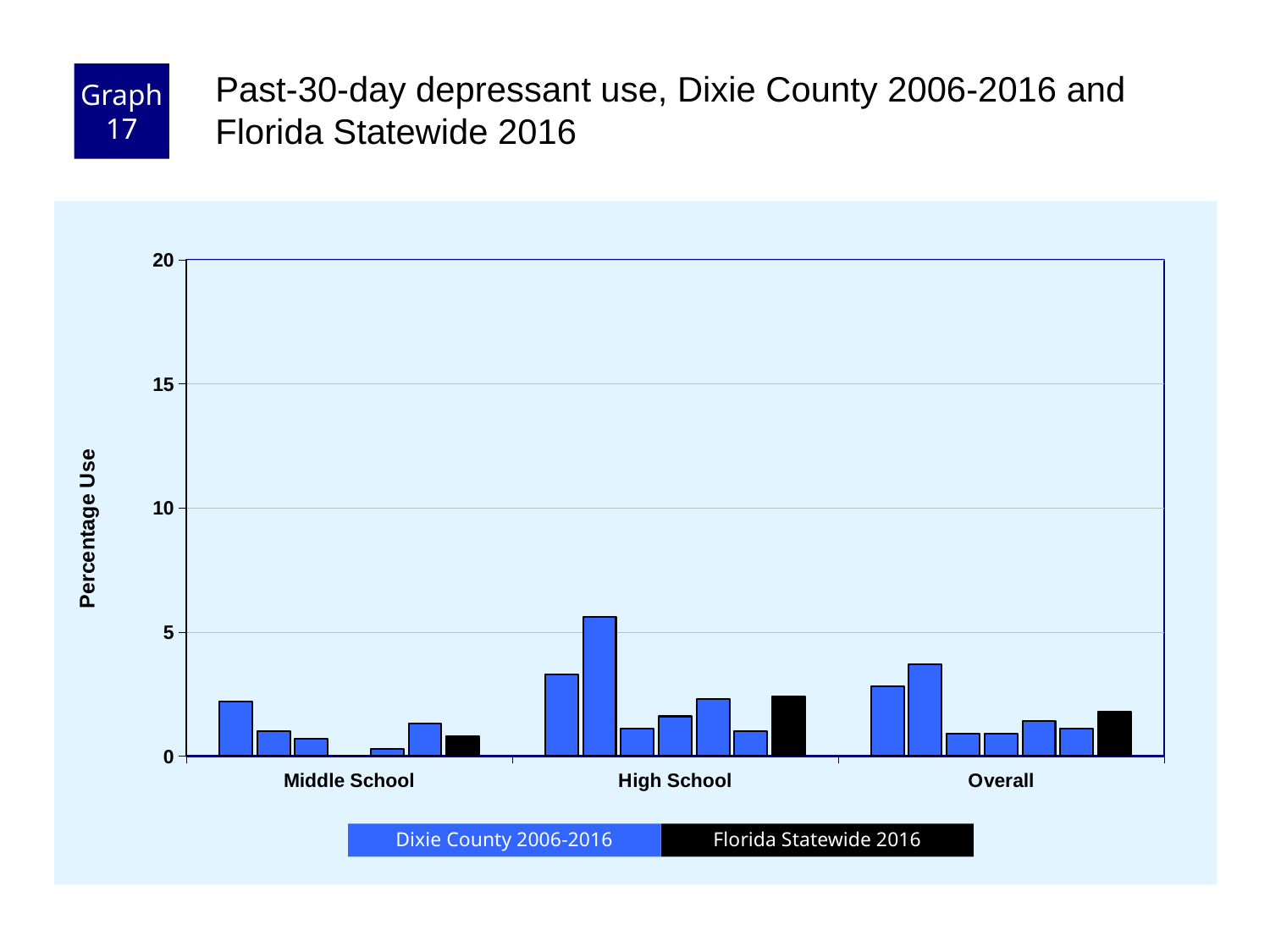
What is the label on the y axis? Percentage Use What colour are the Florida Statewide 2016 bars? black How many categories are shown on the x axis? 3 Is the Florida Statewide 2016 value for Middle School greater or less than 5? less Which category has the lowest Florida Statewide 2016 bar? Middle School What kind of chart is shown on the slide? bar chart Which is larger, the Florida Statewide 2016 value for High School or for Overall? High School Which is larger, the Florida Statewide 2016 value for High School or for Middle School? High School Is the Florida Statewide 2016 value for High School greater or less than 5? less Which category group contains the tallest bar on the chart? High School Is the tallest Dixie County 2006-2016 bar in the High School group greater or less than 5? greater How many series does the legend list? 2